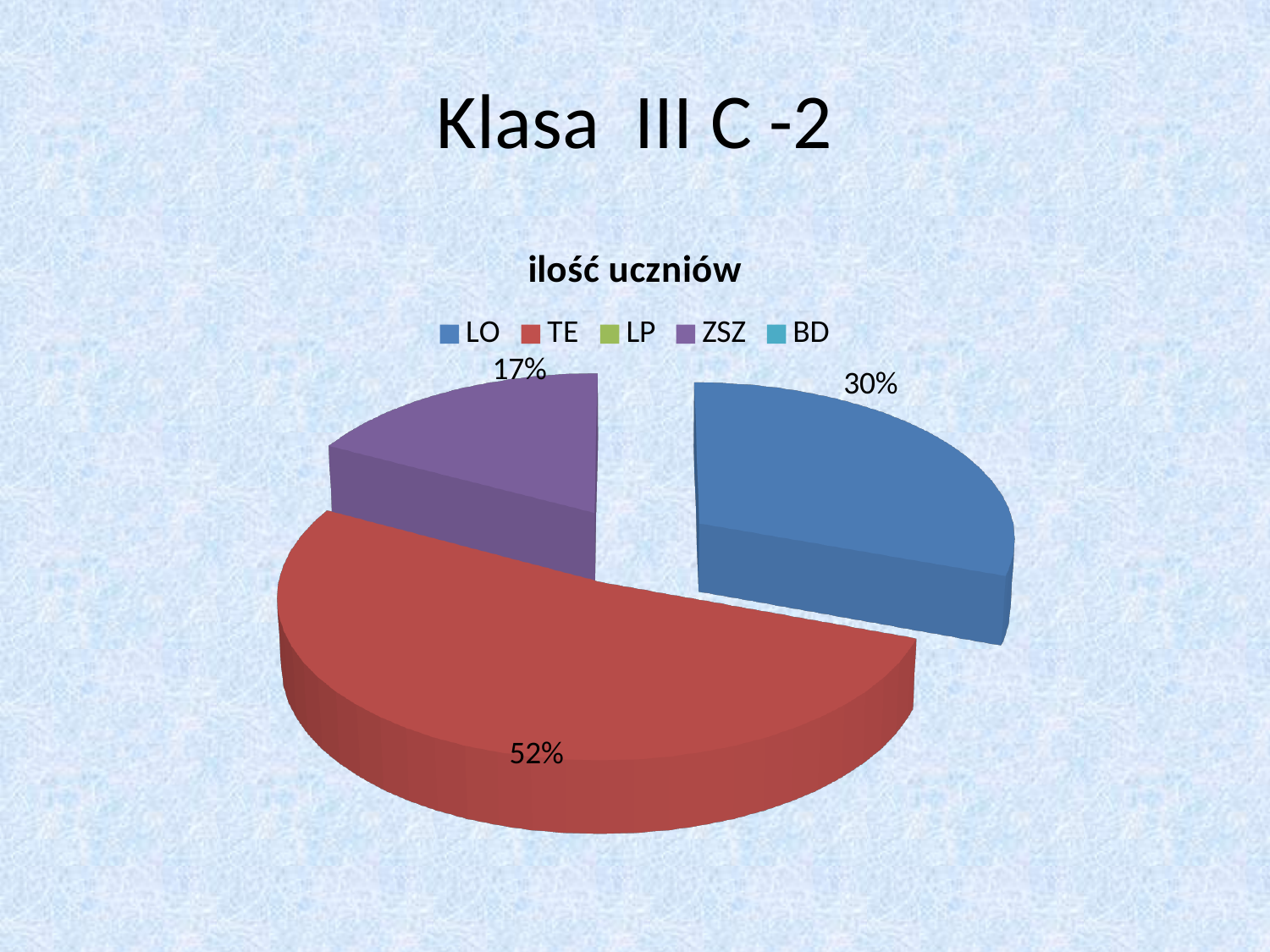
What is the title of the chart? ilość uczniów What share of the pie does LO have? 30% What is the difference in percentage points between the TE slice and the LO slice? 22% What kind of chart is shown on the slide? pie chart Which is larger, the LO slice or the ZSZ slice? LO What share of the pie does ZSZ have? 17% What is the difference in percentage points between the LO slice and the ZSZ slice? 13% What share of the pie does TE have? 52% Which of the visible slices is the smallest? ZSZ What colour is the TE slice? red Which category has the largest slice of the pie? TE How many entries does the legend list? 5